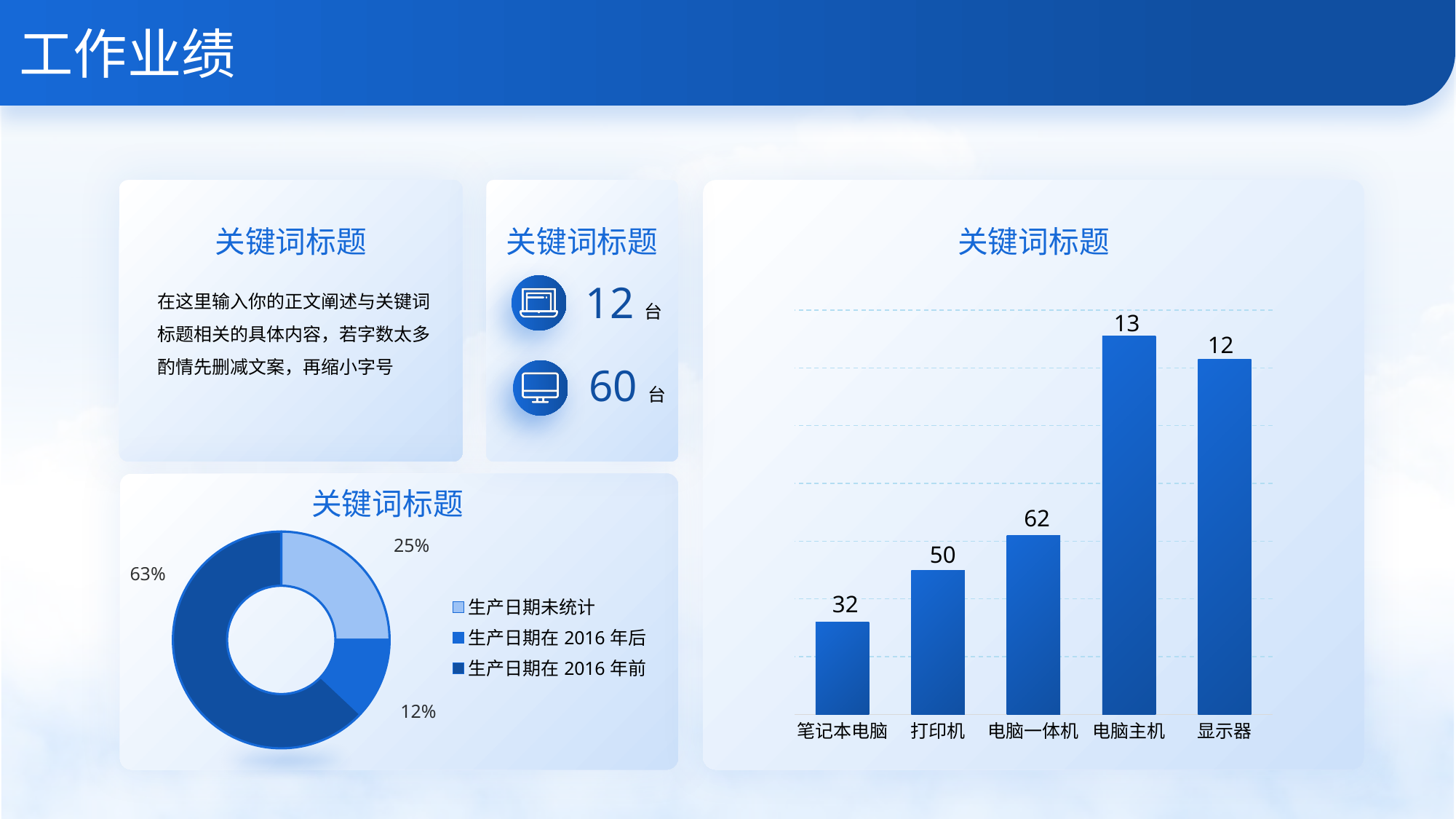
On the pie chart at the bottom left, which category has the smallest share? 生产日期在 2016 年后 On the pie chart at the bottom left, what share does 生产日期在 2016 年前 have? 63% How many entries does the legend of the pie chart at the bottom left list? 3 What kind of chart is the chart on the right of the slide? bar chart On the pie chart at the bottom left, what is the difference between the shares of 生产日期在 2016 年前 and 生产日期在 2016 年后? 51% On the bar chart on the right, what is the difference between the values for 电脑一体机 and 笔记本电脑? 30 On the bar chart on the right, which is larger, the value for 打印机 or the value for 笔记本电脑? 打印机 On the pie chart at the bottom left, what share does 生产日期未统计 have? 25% On the bar chart on the right, what is the value for 电脑一体机? 62 On the bar chart on the right, what is the value for 打印机? 50 On the bar chart on the right, what is the value for 笔记本电脑? 32 How many categories are shown on the bar chart on the right? 5